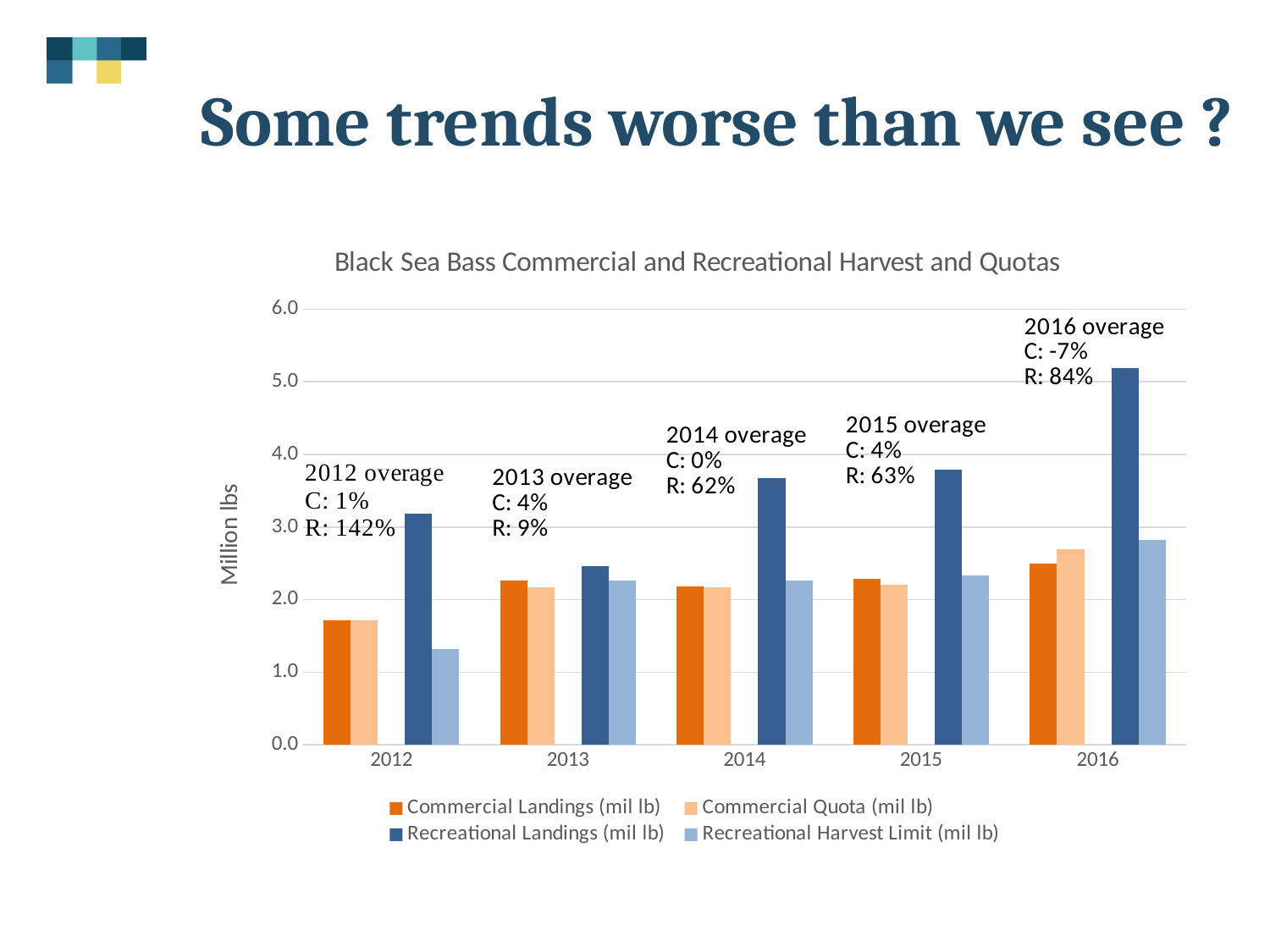
How many years are shown on the x axis of the chart? 5 Is the value for Recreational Harvest Limit (mil lb) in 2012 greater or less than 2.0? less Do Recreational Landings (mil lb) rise or fall from 2013 to 2016? rise In 2016, which is larger: Recreational Landings (mil lb) or Recreational Harvest Limit (mil lb)? Recreational Landings (mil lb) Is the value for Commercial Landings (mil lb) in 2012 greater or less than 2.0? less How many series does the chart legend list? 4 In which year are Recreational Landings (mil lb) highest? 2016 According to the annotation on the chart, what is the recreational (R) overage for 2012? 142% In which year are Recreational Landings (mil lb) lowest? 2013 Is the value for Recreational Landings (mil lb) in 2016 greater or less than 5.0? greater What is the title of the chart? Black Sea Bass Commercial and Recreational Harvest and Quotas What type of chart is shown on the slide? bar chart